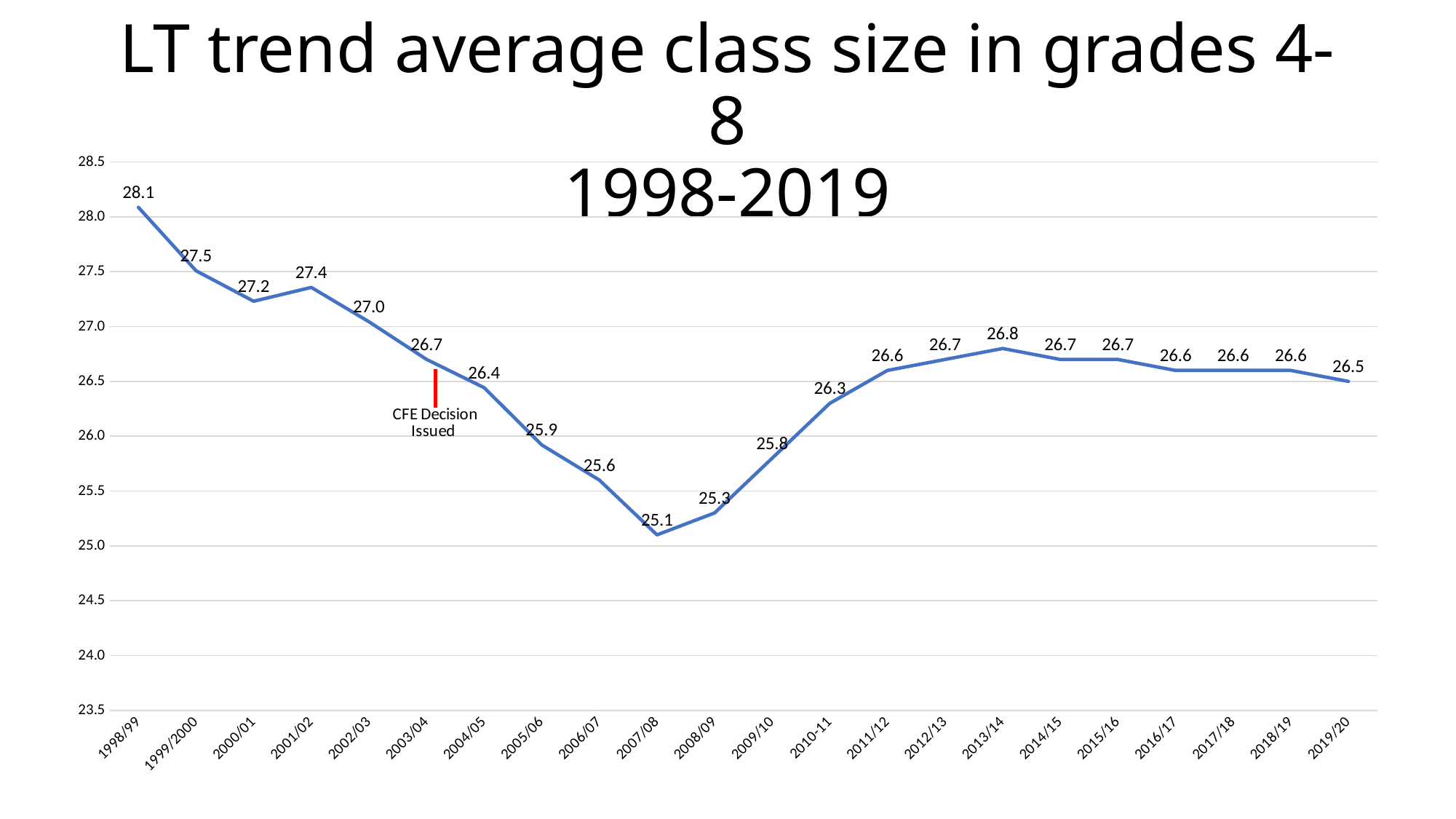
What type of chart is shown on the slide? Line chart Which school year had the lowest average class size? 2007/08 What is the difference between the average class size in 1998/99 and in 2007/08? 3.0 What was the average class size in 2019/20? 26.5 How many school years are plotted on the chart? 22 Which school year had the highest average class size? 1998/99 What was the average class size in 2013/14? 26.8 What was the average class size in 1998/99? 28.1 What was the average class size in 2007/08? 25.1 Did the average class size rise or fall between 1998/99 and 2007/08? Fall What event does the red marker on the chart indicate? CFE Decision Issued Which year had a larger average class size, 2003/04 or 2010/11? 2003/04